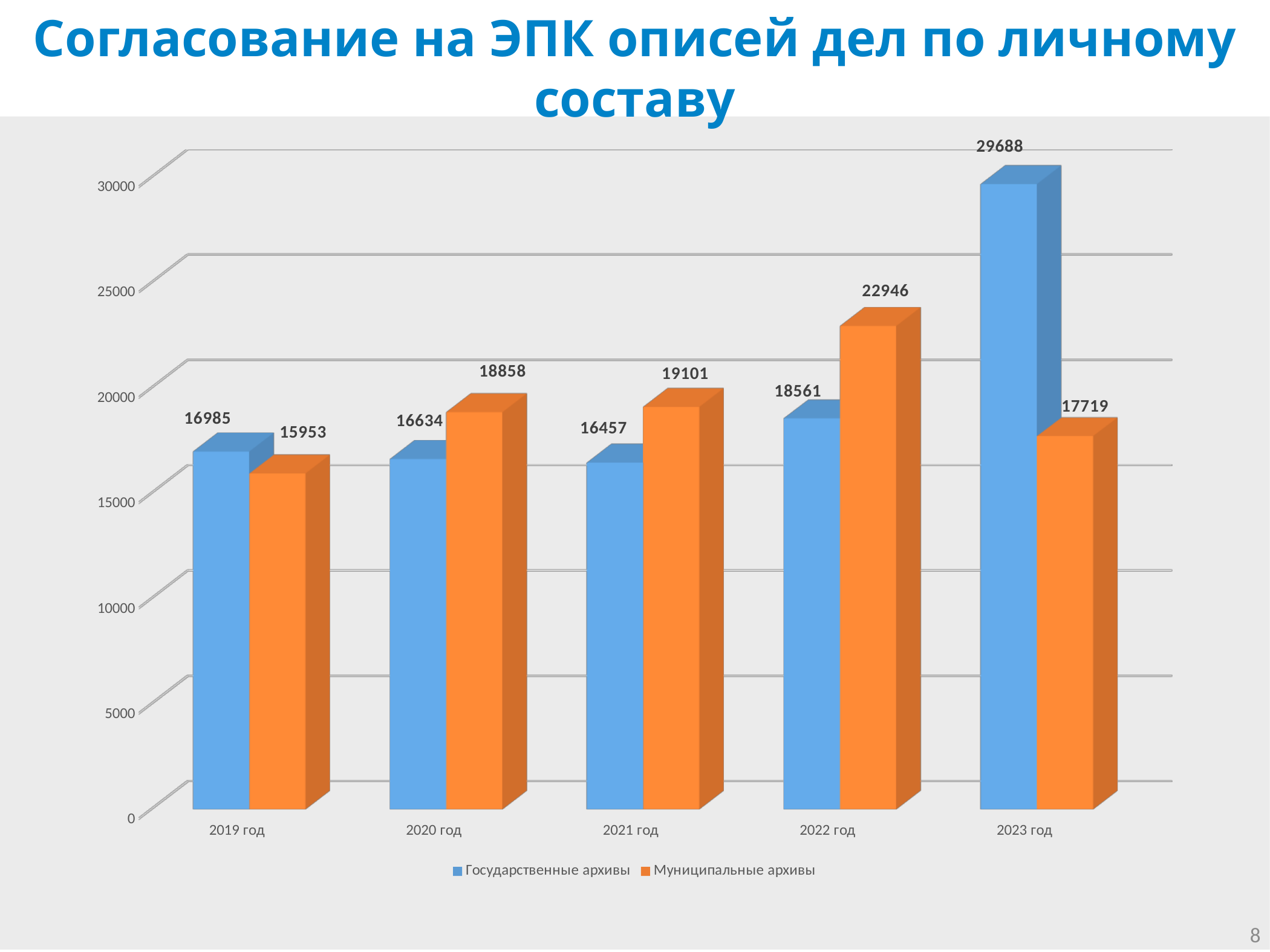
Which is larger in 2021 год: Государственные архивы or Муниципальные архивы? Муниципальные архивы Is the value for Муниципальные архивы in 2022 год greater or less than 20000? greater What kind of chart is shown on the slide? bar chart Which year has the lowest value for Муниципальные архивы? 2019 год Which colour represents Муниципальные архивы in the chart? orange What is the difference between Государственные архивы and Муниципальные архивы in 2023 год? 11969 How many years are shown on the x axis? 5 What is the value for Муниципальные архивы in 2019 год? 15953 What is the value for Муниципальные архивы in 2022 год? 22946 What is the value for Государственные архивы in 2023 год? 29688 Which year has the highest value for Государственные архивы? 2023 год How many series does the legend list? 2